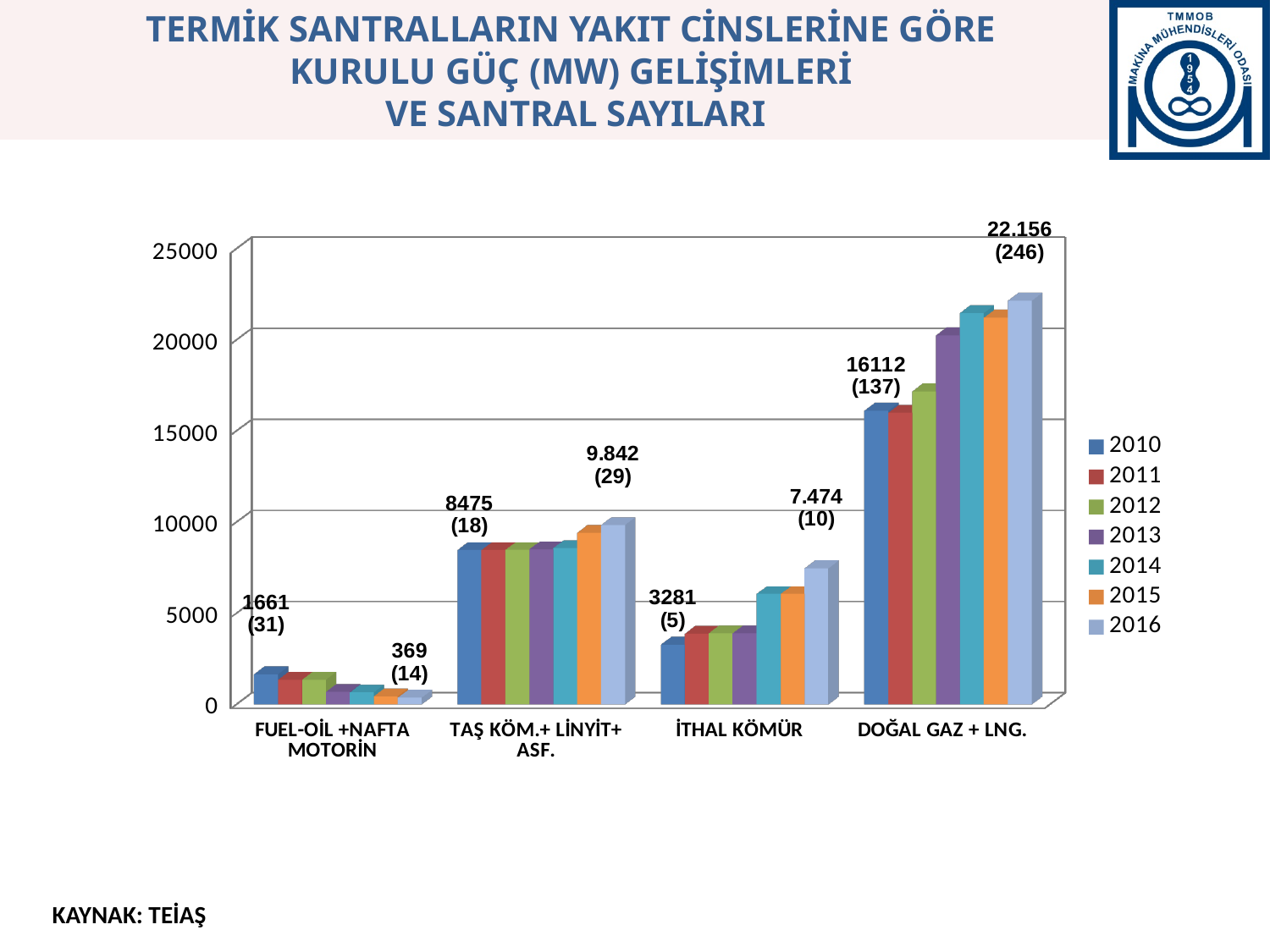
Is the 2014 value for DOĞAL GAZ + LNG. greater or less than 20000? greater What is the labelled 2016 value for İTHAL KÖMÜR? 7.474 What number appears in parentheses under the 2016 label for DOĞAL GAZ + LNG.? 246 How many fuel-type categories are shown on the x axis? 4 What kind of chart is shown on the slide? bar chart Do the values for FUEL-OİL +NAFTA MOTORİN rise or fall from 2010 to 2016? fall How many series does the legend list? 7 Which category has the highest 2016 value? DOĞAL GAZ + LNG. Which is larger in 2010: TAŞ KÖM.+ LİNYİT+ ASF. or İTHAL KÖMÜR? TAŞ KÖM.+ LİNYİT+ ASF. What is the labelled 2016 value for FUEL-OİL +NAFTA MOTORİN? 369 Which category has the lowest 2016 value? FUEL-OİL +NAFTA MOTORİN What is the labelled 2010 value for DOĞAL GAZ + LNG.? 16112